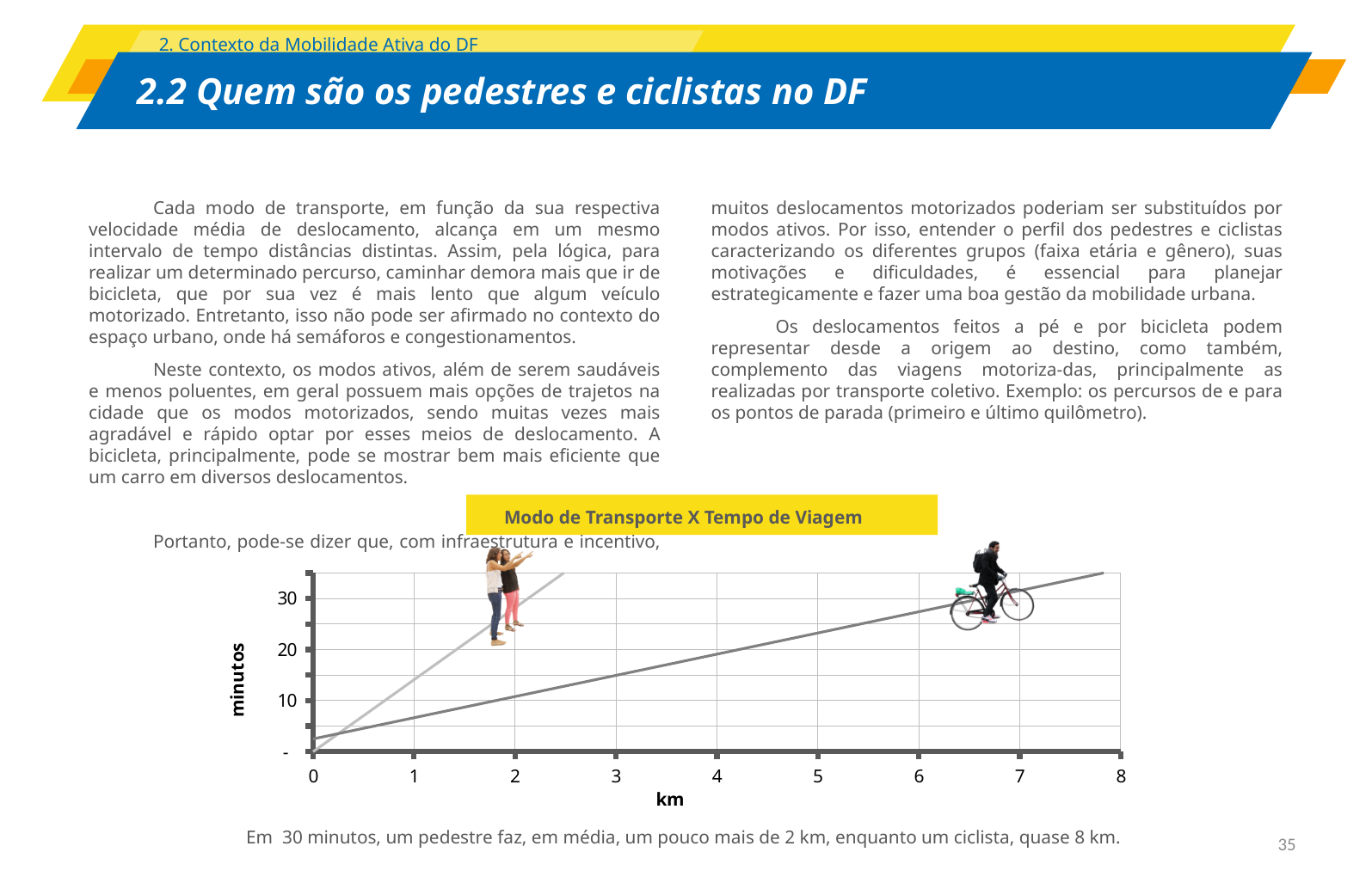
What is the label of the vertical axis of the chart? minutos What is the title of the chart on the slide? Modo de Transporte X Tempo de Viagem At 8 km, is the value of the shallower line (cyclist) greater or less than 30 minutos? greater How many labelled tick values are shown on the horizontal (km) axis of the chart? 9 How many lines are plotted in the chart? 2 Do the values of the lines in the chart rise or fall as km increases along the x axis? rise At 1 km, is the value of the steeper line (pedestrians) greater or less than 10 minutos? greater What kind of chart is shown under the title "Modo de Transporte X Tempo de Viagem"? line chart Which line reaches 30 minutos at a shorter distance: the steeper line (with the pedestrians image) or the shallower line (with the cyclist image)? the steeper line (pedestrians) At 6 km, is the value of the shallower line (cyclist) greater or less than 30 minutos? less What is the highest labelled value on the horizontal (km) axis of the chart? 8